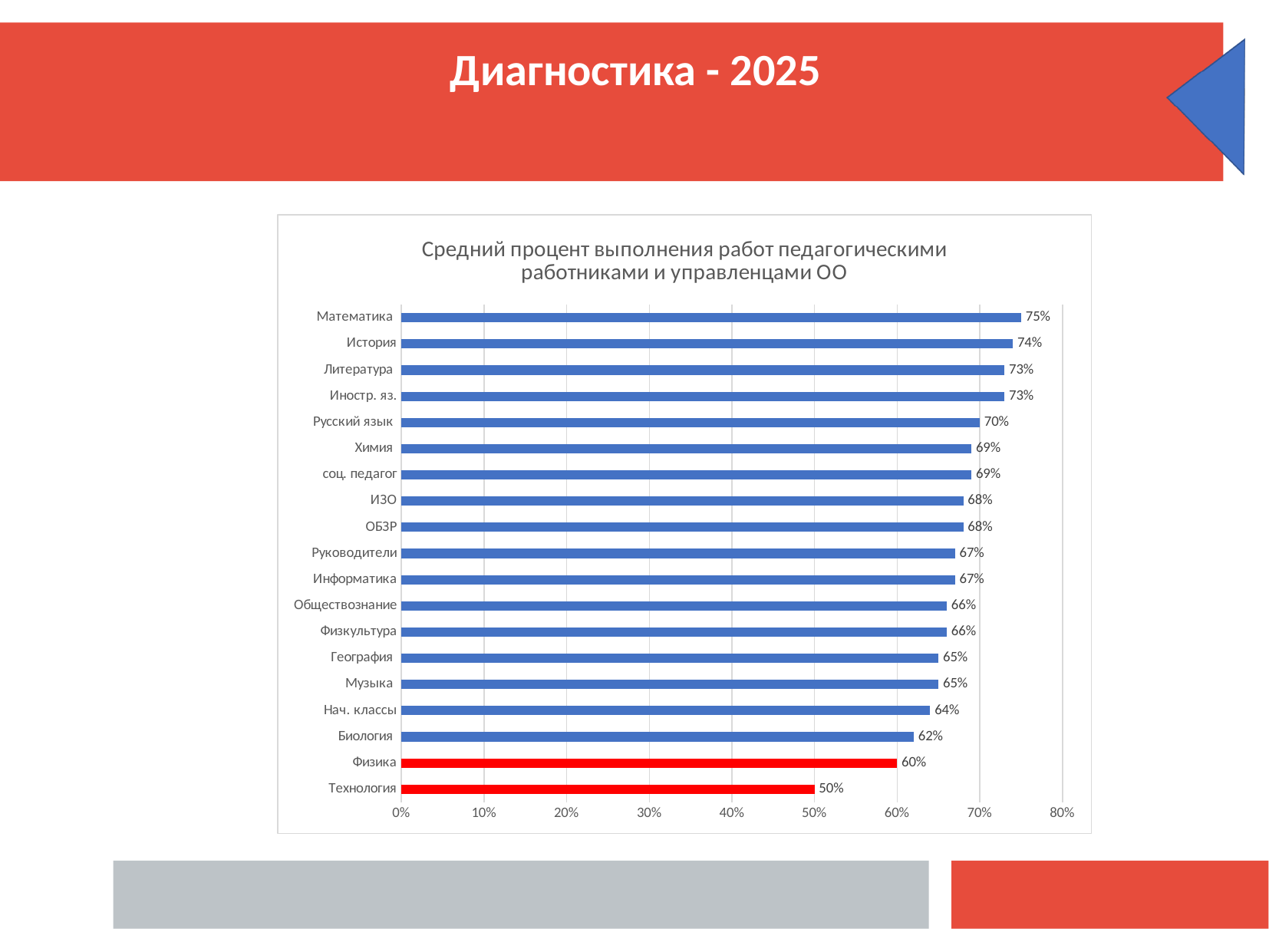
Which two categories are shown with red bars? Физика and Технология Which is larger, the value for История or the value for Биология? История What is the value for Математика? 75% What is the value for Биология? 62% Which category has the highest value? Математика Which category has the lowest value? Технология What is the difference between the values for Физика and Технология? 10% What is the value for Технология? 50% What is the value for Русский язык? 70% What is the difference between the values for Математика and Технология? 25% How many categories are shown in the chart? 19 What kind of chart is shown on the slide? Bar chart